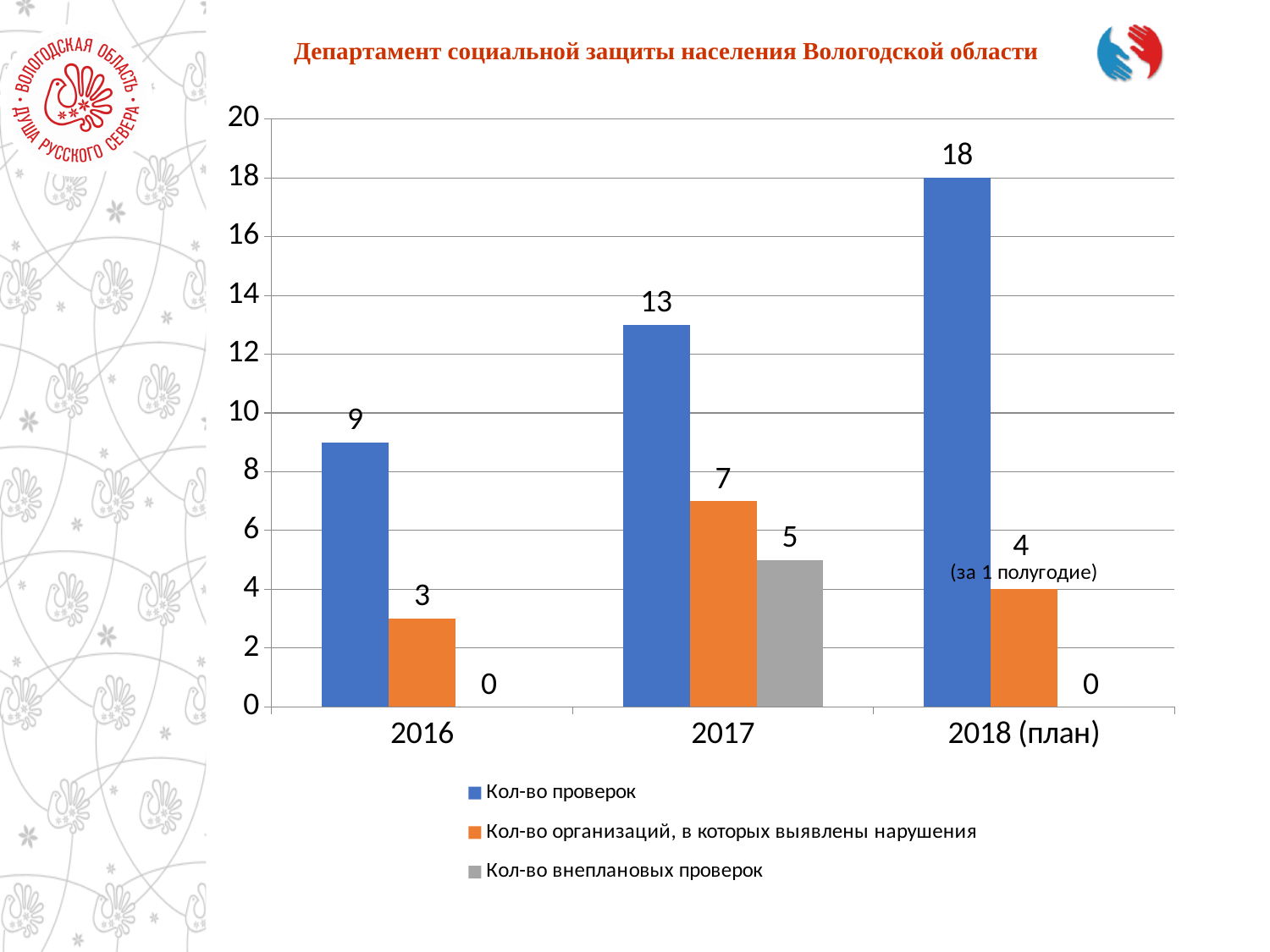
Which is larger: 'Кол-во организаций, в которых выявлены нарушения' in 2017 or in 2018 (план)? 2017 Does 'Кол-во проверок' rise or fall from 2016 to 2018 (план)? rise How many year categories are shown on the x axis? 3 Which year has the highest value for 'Кол-во проверок'? 2018 (план) What is the value of 'Кол-во организаций, в которых выявлены нарушения' for 2016? 3 What kind of chart is shown on the slide? bar chart Which year has the lowest value for 'Кол-во организаций, в которых выявлены нарушения'? 2016 What is the value of 'Кол-во внеплановых проверок' for 2018 (план)? 0 How many series does the legend list? 3 What is the value of 'Кол-во внеплановых проверок' for 2017? 5 What is the value of 'Кол-во проверок' for 2017? 13 What is the difference between 'Кол-во проверок' in 2018 (план) and in 2016? 9